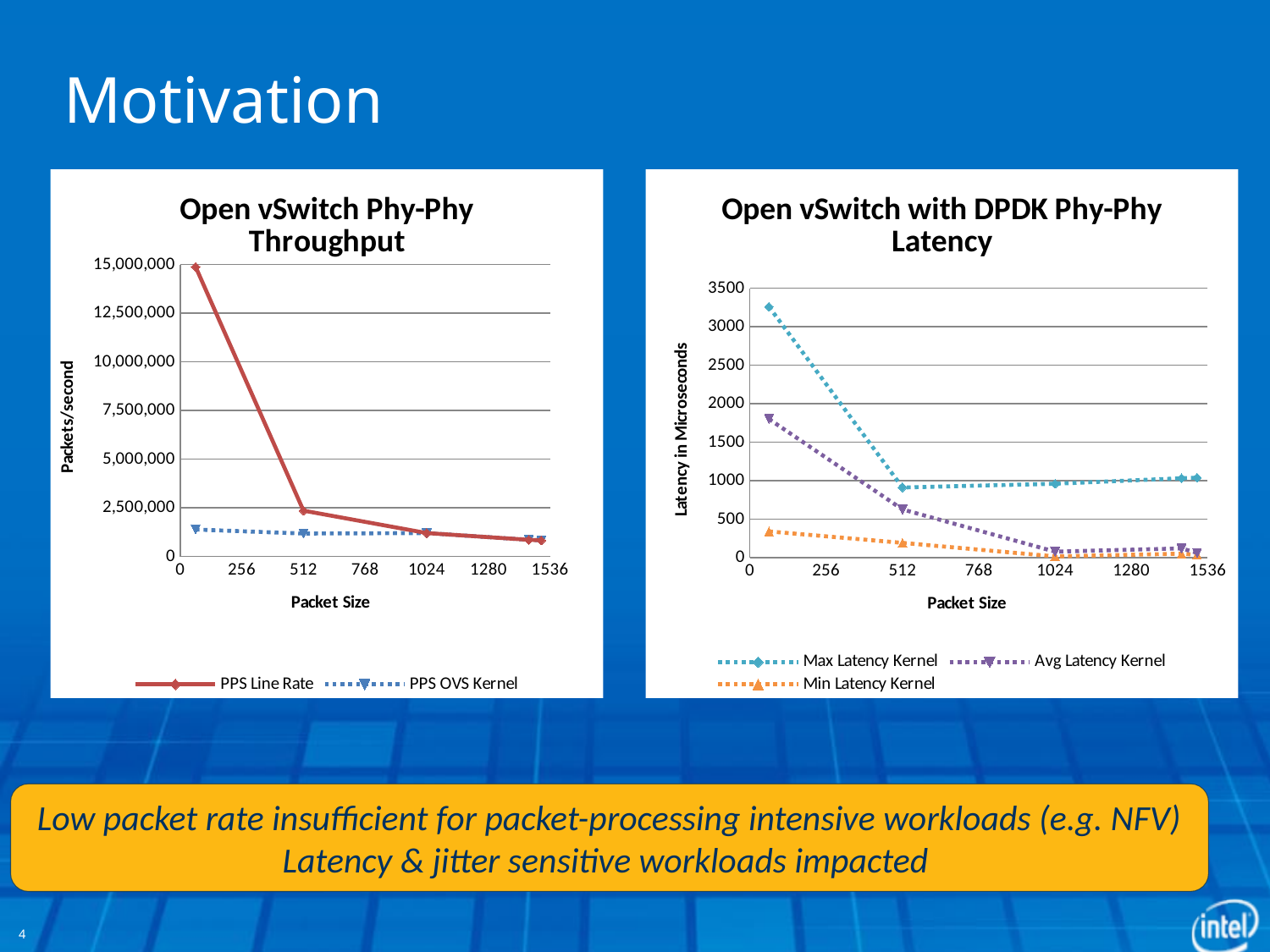
What type of chart is the 'Open vSwitch Phy-Phy Throughput' chart? line chart What is the y-axis label of the 'Open vSwitch with DPDK Phy-Phy Latency' chart? Latency in Microseconds In the 'Open vSwitch Phy-Phy Throughput' chart, is the PPS OVS Kernel value at the smallest packet size greater or less than 2,500,000? less How many series does the legend of the 'Open vSwitch with DPDK Phy-Phy Latency' chart list? 3 In the 'Open vSwitch with DPDK Phy-Phy Latency' chart, is the Min Latency Kernel value at the smallest packet size greater or less than 500? less In the 'Open vSwitch with DPDK Phy-Phy Latency' chart, which series has the higher value at the smallest packet size, Max Latency Kernel or Avg Latency Kernel? Max Latency Kernel In the 'Open vSwitch with DPDK Phy-Phy Latency' chart, is the Max Latency Kernel value at the smallest packet size greater or less than 3000? greater How many series does the legend of the 'Open vSwitch Phy-Phy Throughput' chart list? 2 In the 'Open vSwitch Phy-Phy Throughput' chart, does the PPS Line Rate rise or fall as packet size increases? fall